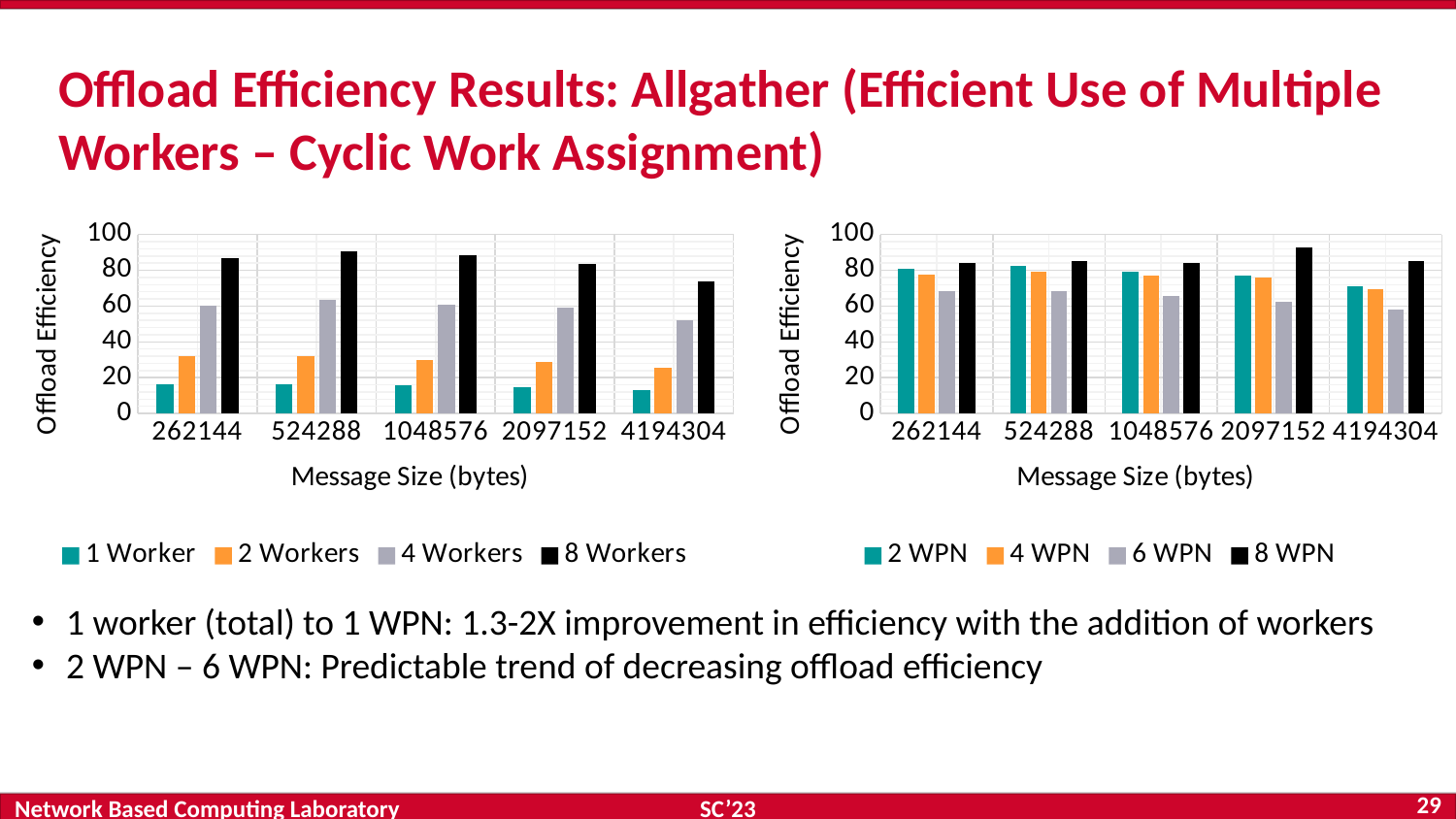
How many series does the legend of the right chart list? 4 How many message sizes are shown on the x axis of the left chart? 5 In the right chart, is the value for 8 WPN at message size 2097152 greater or less than 80? greater In the left chart, which series has the lowest offload efficiency at message size 4194304? 1 Worker In the left chart, is the value for 1 Worker at message size 262144 greater or less than 20? less In the left chart, which series has the highest offload efficiency at message size 262144? 8 Workers In the left chart, is the value for 8 Workers at message size 262144 greater or less than 80? greater In the right chart, do the 6 WPN values rise or fall as message size increases along the x axis? fall In the right chart, which is larger at message size 4194304: the value for 2 WPN or the value for 6 WPN? 2 WPN What kind of chart is the left chart on the slide? bar chart In the right chart, which series has the lowest offload efficiency at message size 2097152? 6 WPN